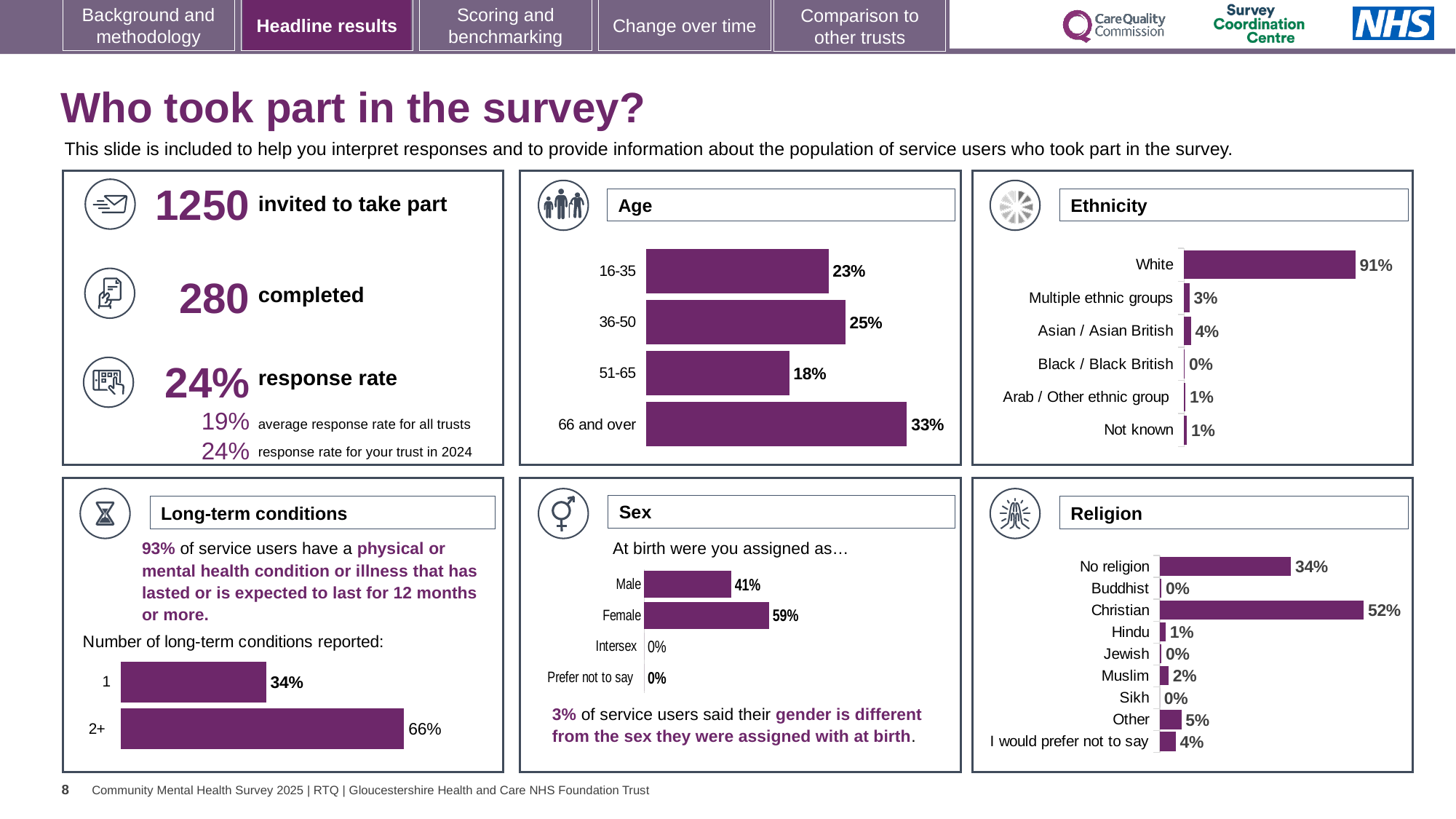
In the Age chart, which age group has the lowest percentage? 51-65 In the Long-term conditions chart, what percentage of service users reported 2+ long-term conditions? 66% In the Sex chart, what percentage of respondents were assigned Female at birth? 59% In the Age chart, what percentage of respondents were aged 66 and over? 33% What type of chart is used in the Age panel? Bar chart In the Ethnicity chart, which is larger: Asian / Asian British or Multiple ethnic groups? Asian / Asian British In the Ethnicity chart, what percentage of respondents were White? 91% In the Sex chart, what is the difference between the Female and Male percentages? 18% In the Age chart, what is the difference between the 36-50 and 16-35 percentages? 2% In the Religion chart, which category has the highest percentage? Christian In the Religion chart, what percentage of respondents reported No religion? 34% How many categories does the Ethnicity chart show? 6